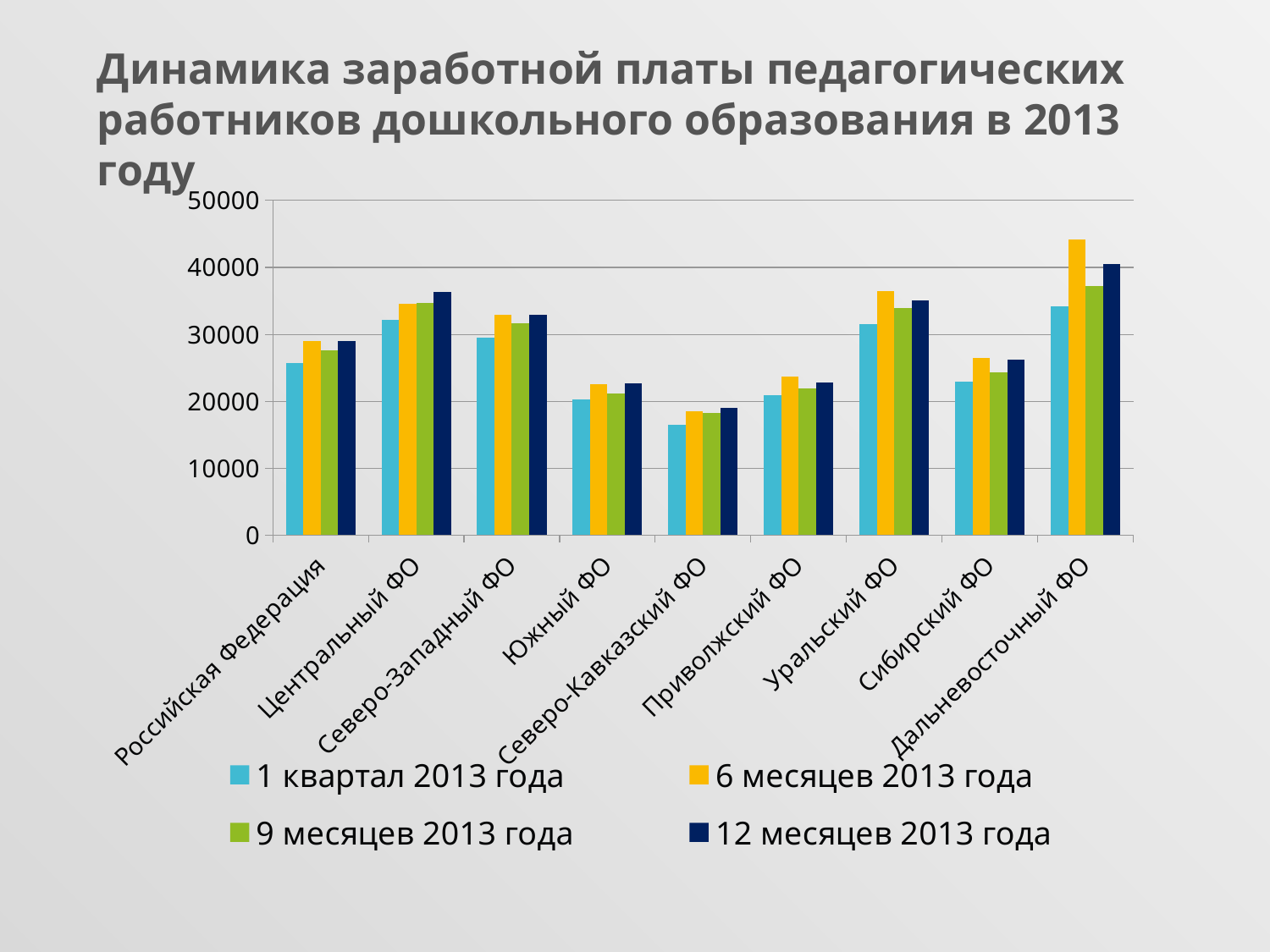
How many categories (regions) are shown on the x axis? 9 Which region has the highest bar for the series '6 месяцев 2013 года'? Дальневосточный ФО Which series is shown in dark blue in the legend? 12 месяцев 2013 года Is the value for Северо-Кавказский ФО in '1 квартал 2013 года' greater or less than 20000? less How many series does the legend list? 4 What kind of chart is shown on the slide? bar chart For '1 квартал 2013 года', which is larger: Северо-Западный ФО or Южный ФО? Северо-Западный ФО Is the value for Приволжский ФО in '6 месяцев 2013 года' greater or less than 30000? less Is the value for Дальневосточный ФО in '6 месяцев 2013 года' greater or less than 40000? greater Which region has the lowest bar for the series '1 квартал 2013 года'? Северо-Кавказский ФО For Дальневосточный ФО, which is larger: the value for '6 месяцев 2013 года' or for '12 месяцев 2013 года'? 6 месяцев 2013 года